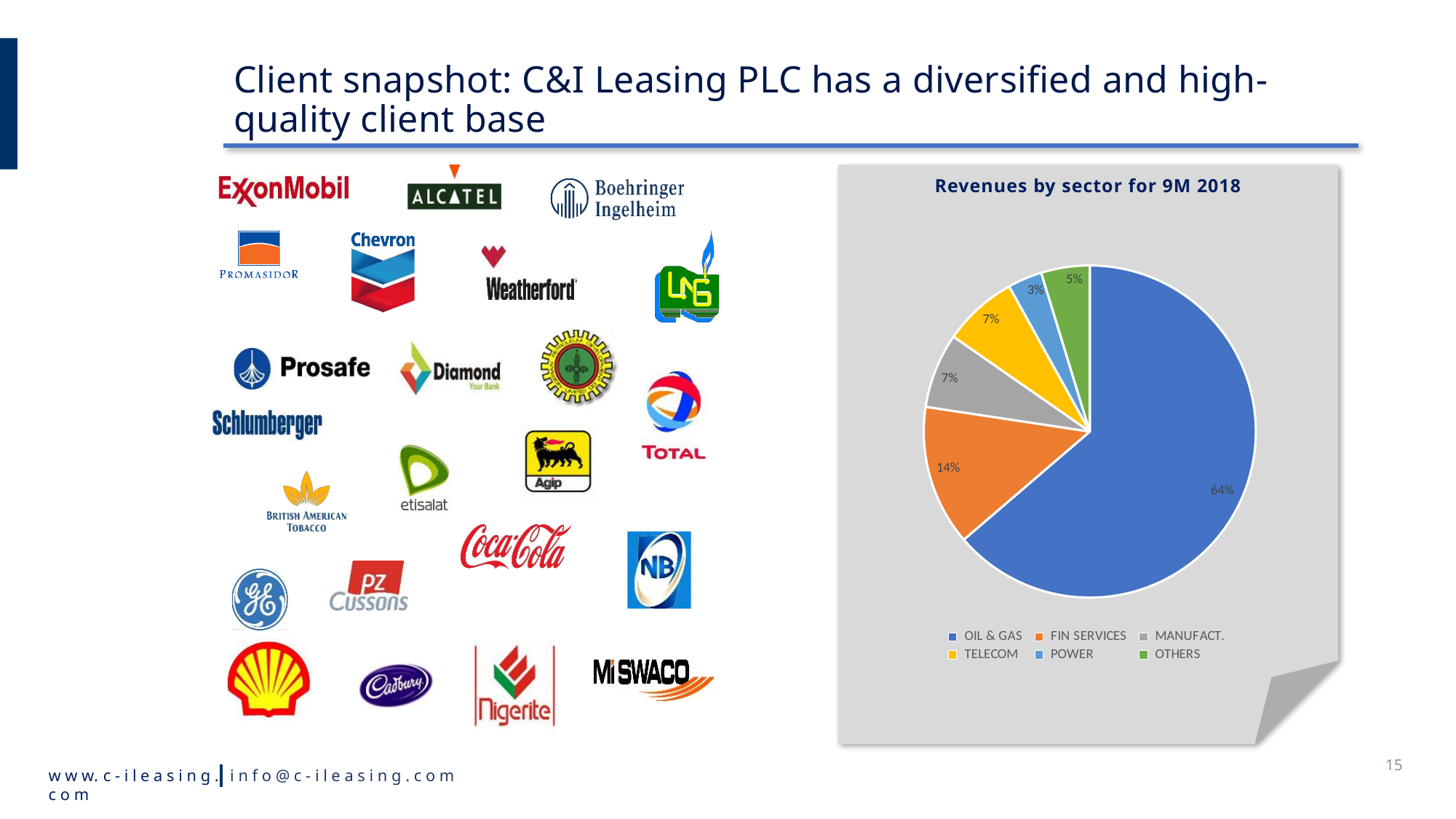
What is the difference in percentage points between the OIL & GAS share and the FIN SERVICES share? 50 What share of revenues does FIN SERVICES account for? 14% What share of revenues does OIL & GAS account for? 64% What share of revenues does TELECOM account for? 7% What share of revenues does OTHERS account for? 5% How many sectors are shown in the pie chart? 6 What is the title of the chart? Revenues by sector for 9M 2018 What type of chart is shown on the slide? pie chart Which sector has the smallest share of revenues? POWER Which sector has the largest share of revenues? OIL & GAS What share of revenues does POWER account for? 3% Which has a larger share of revenues, OTHERS or POWER? OTHERS